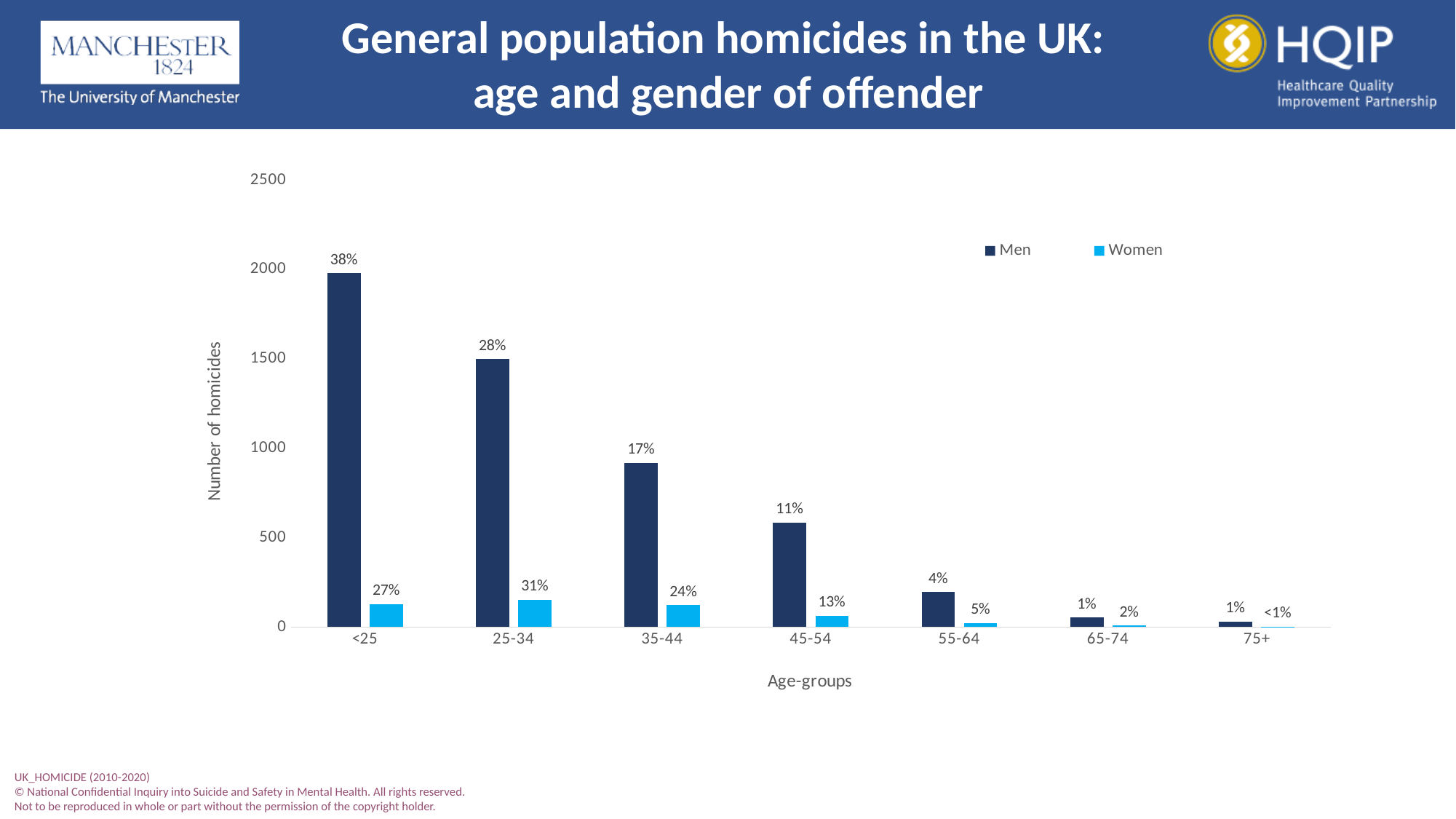
How many series does the legend list? 2 What percentage label is shown on the Women bar for the 75+ age group? <1% Which is larger, the Men bar for 25-34 or the Men bar for 35-44? 25-34 How many age groups are shown on the x axis? 7 What percentage label is shown on the Women bar for the 25-34 age group? 31% What percentage label is shown on the Men bar for the <25 age group? 38% Which age group has the tallest Men bar? <25 Do the Men bars rise or fall as the age groups increase along the x axis? fall Which age group has the shortest Women bar? 75+ Is the number of homicides for Men in the <25 age group greater or less than 1500? greater What kind of chart is shown on the slide? bar chart Is the number of homicides for Men in the 35-44 age group greater or less than 1000? less